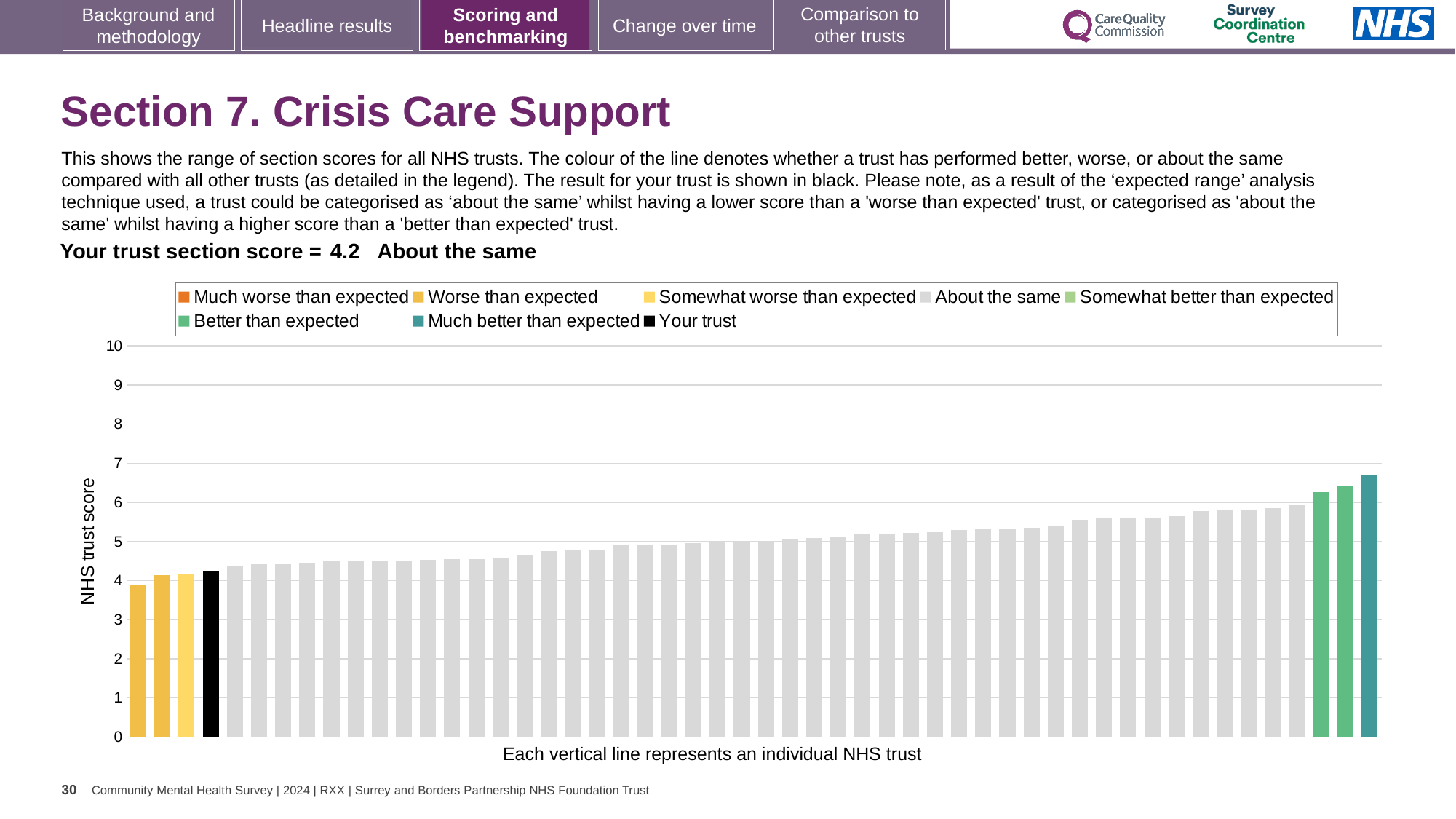
Is the value of the highest bar greater or less than 6? greater What is the label on the y axis of the chart? NHS trust score Is the value of the lowest bar greater or less than 5? less Which category is your trust placed in for this section? About the same Which legend category does the highest bar belong to? Much better than expected How many bars are coloured as 'Much better than expected'? 1 How many entries does the chart legend list? 8 Is the value for your trust greater or less than 5? less Do the bar values rise or fall from left to right along the x axis? rise What kind of chart is shown on the slide? bar chart What is the section score for your trust? 4.2